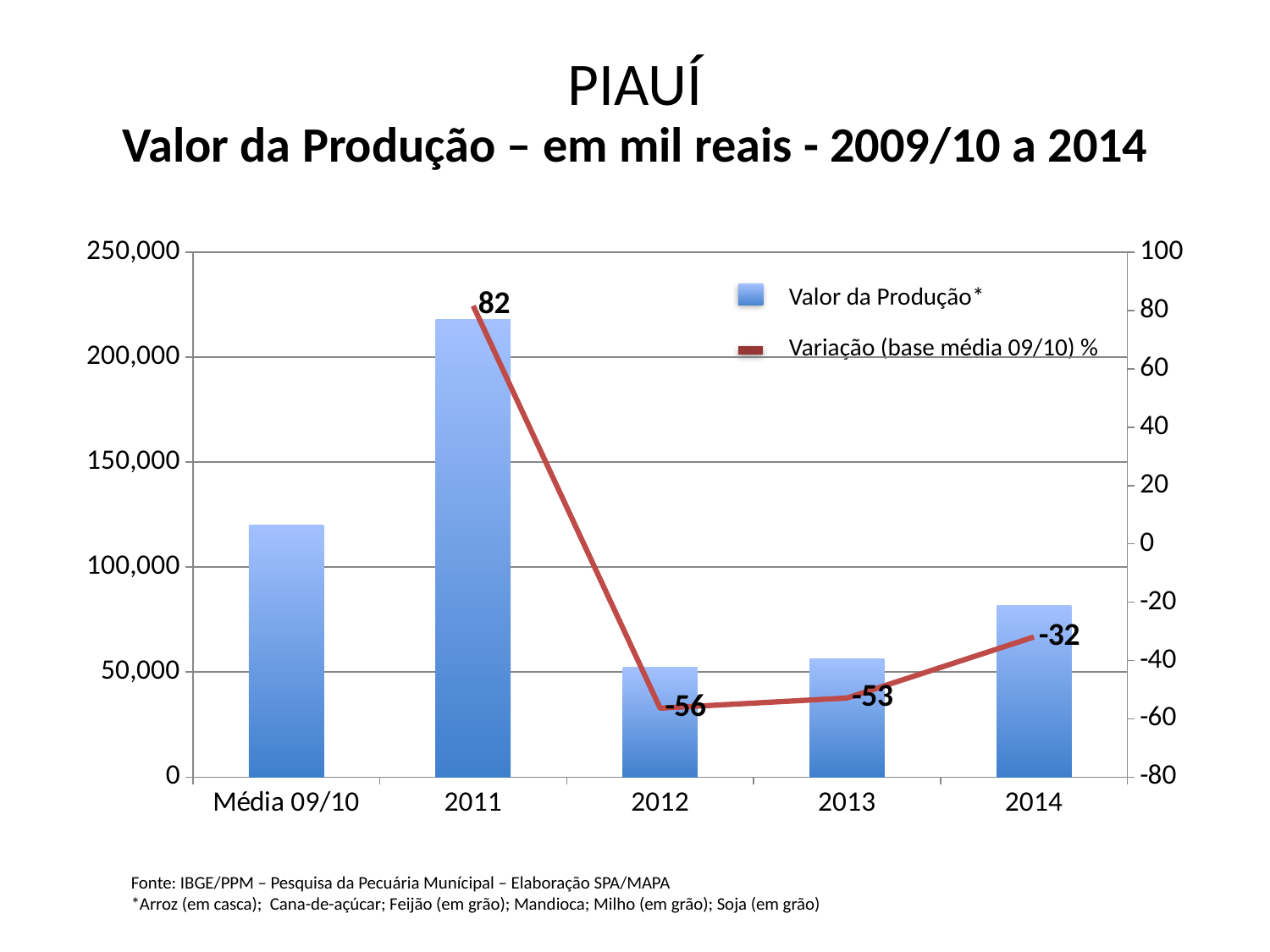
How many categories are shown on the x axis? 5 What is the Variação (base média 09/10) % value for 2011? 82 Is the Valor da Produção bar for 2011 greater or less than 200,000? greater What is the difference between the Variação values for 2011 and 2012? 138 What is the Variação (base média 09/10) % value for 2012? -56 Which year has the lowest Variação (base média 09/10) % value? 2012 Does the Variação line rise or fall from 2012 to 2014? rise Which year has the highest Valor da Produção bar? 2011 What is the Variação (base média 09/10) % value for 2014? -32 Which is larger, the Valor da Produção bar for Média 09/10 or for 2014? Média 09/10 How many series does the legend list? 2 Is the Valor da Produção bar for 2014 greater or less than 100,000? less